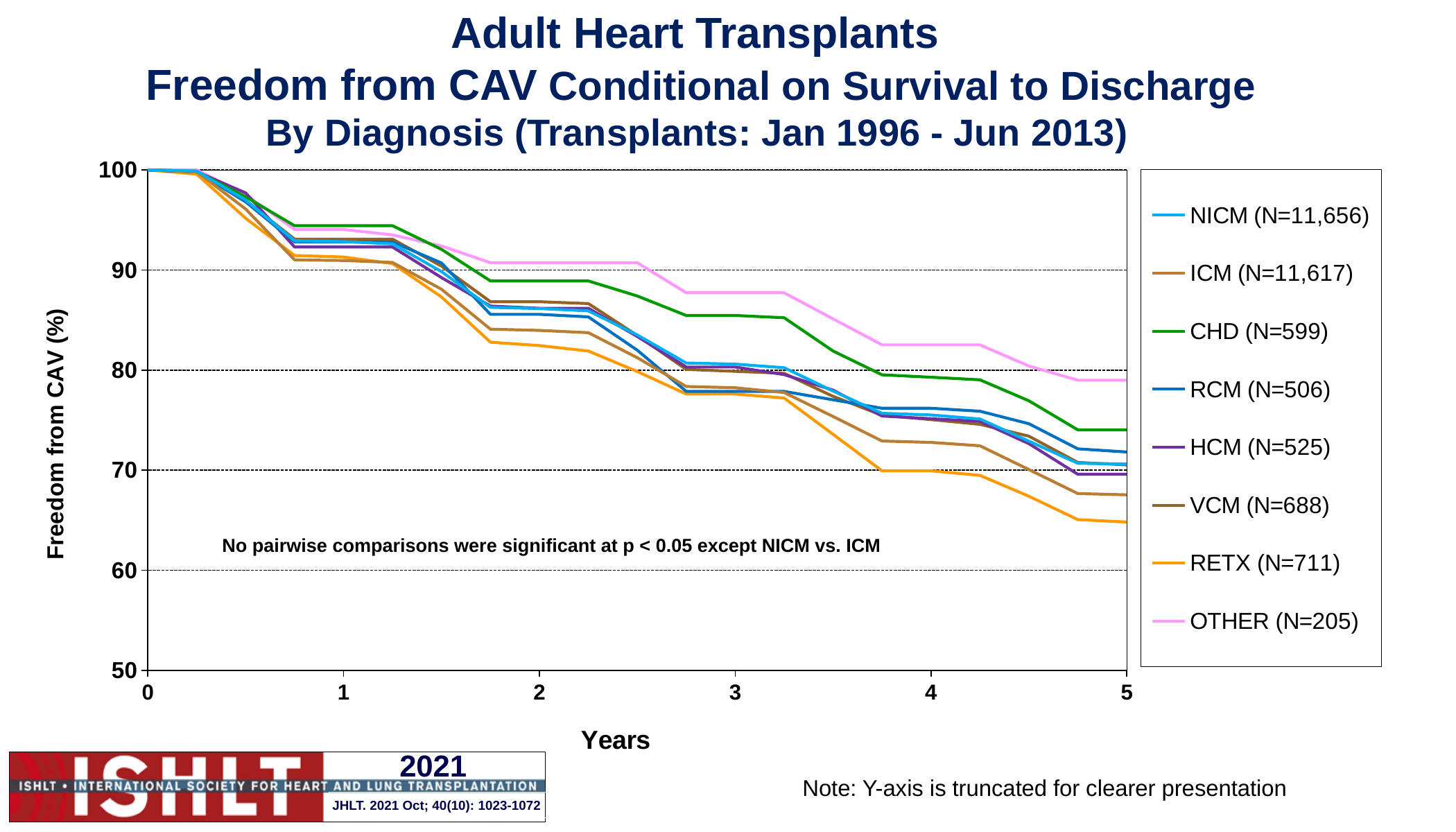
At 5 years, which has the larger freedom from CAV: CHD or RETX? CHD Is the freedom from CAV for RETX at 5 years greater or less than 70? less At 3 years, which has the larger freedom from CAV: OTHER or ICM? OTHER What is the sample size (N) shown in the legend for NICM? 11,656 How many series does the legend list? 8 Do the freedom from CAV values rise or fall as years increase? fall Which diagnosis group has the highest freedom from CAV at 5 years? OTHER (N=205) Is the freedom from CAV for OTHER at 3 years greater or less than 90? less What is the freedom from CAV value for all diagnosis groups at year 0? 100 What kind of chart is shown on the slide? line chart Which diagnosis group has the lowest freedom from CAV at 5 years? RETX (N=711) Is the freedom from CAV for CHD at 5 years greater or less than 70? greater